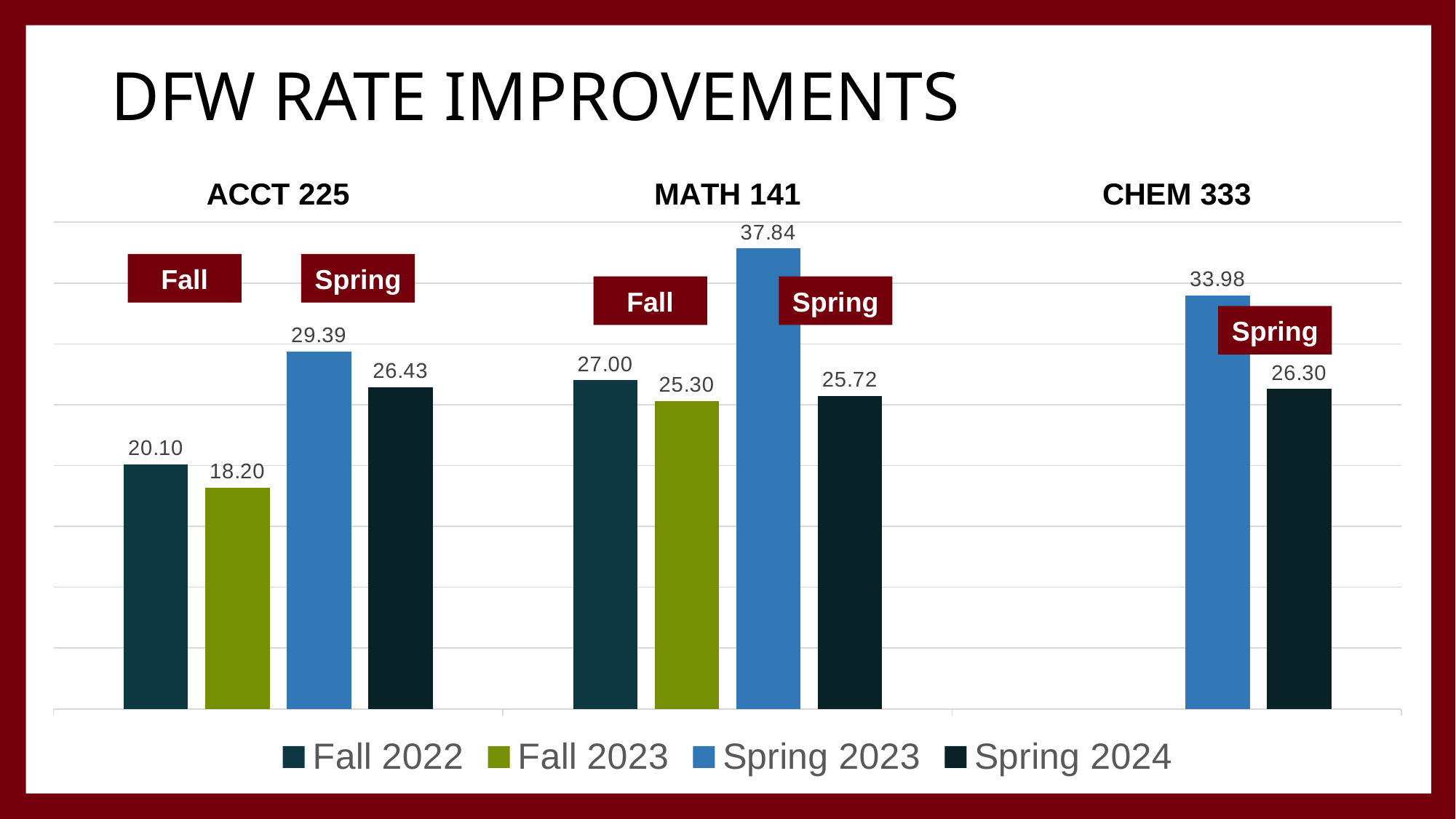
Which course has the highest Spring 2023 value? MATH 141 What is the Spring 2024 value for CHEM 333? 26.30 What is the Spring 2023 value for MATH 141? 37.84 Which is larger for ACCT 225: the Fall 2022 value or the Fall 2023 value? Fall 2022 What is the difference between the Spring 2023 and Spring 2024 values for CHEM 333? 7.68 What is the difference between the Spring 2023 and Spring 2024 values for MATH 141? 12.12 How many series does the legend list? 4 What is the Fall 2023 value for ACCT 225? 18.20 What is the Fall 2022 value for MATH 141? 27.00 What kind of chart is shown on the slide? Bar chart Which course has the lowest Fall 2023 value? ACCT 225 How many courses are shown on the x axis? 3